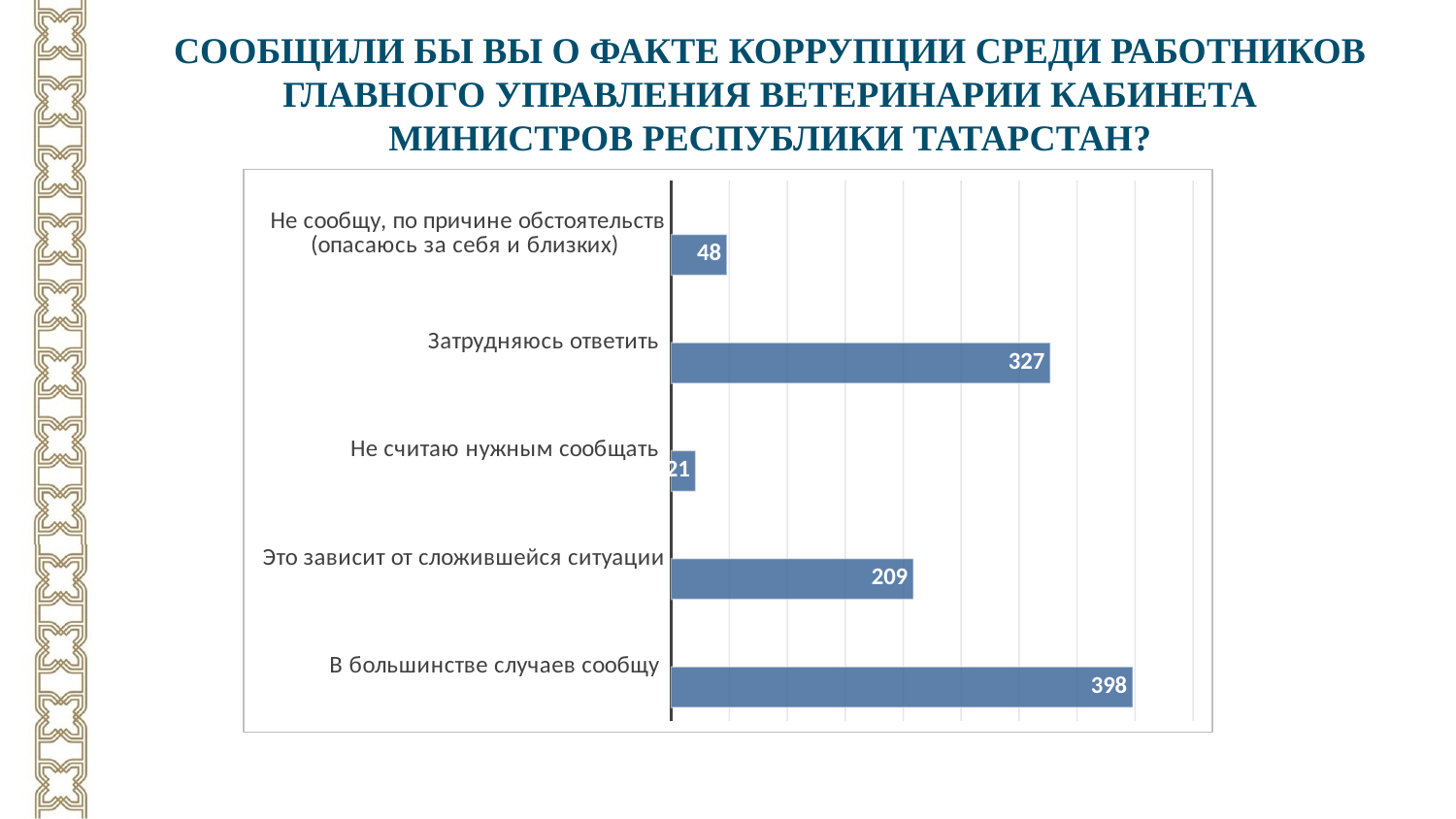
What is the difference between the values for "В большинстве случаев сообщу" and "Затрудняюсь ответить"? 71 What is the value for "Не считаю нужным сообщать"? 21 What is the value for "В большинстве случаев сообщу"? 398 What is the difference between the values for "Это зависит от сложившейся ситуации" and "Не сообщу, по причине обстоятельств (опасаюсь за себя и близких)"? 161 Which is larger: the value for "Затрудняюсь ответить" or the value for "Это зависит от сложившейся ситуации"? Затрудняюсь ответить Which category has the highest value? В большинстве случаев сообщу Which category has the lowest value? Не считаю нужным сообщать What is the value for "Это зависит от сложившейся ситуации"? 209 What is the value for "Не сообщу, по причине обстоятельств (опасаюсь за себя и близких)"? 48 How many categories are shown in the chart? 5 What is the value for "Затрудняюсь ответить"? 327 What kind of chart is shown on the slide? Bar chart